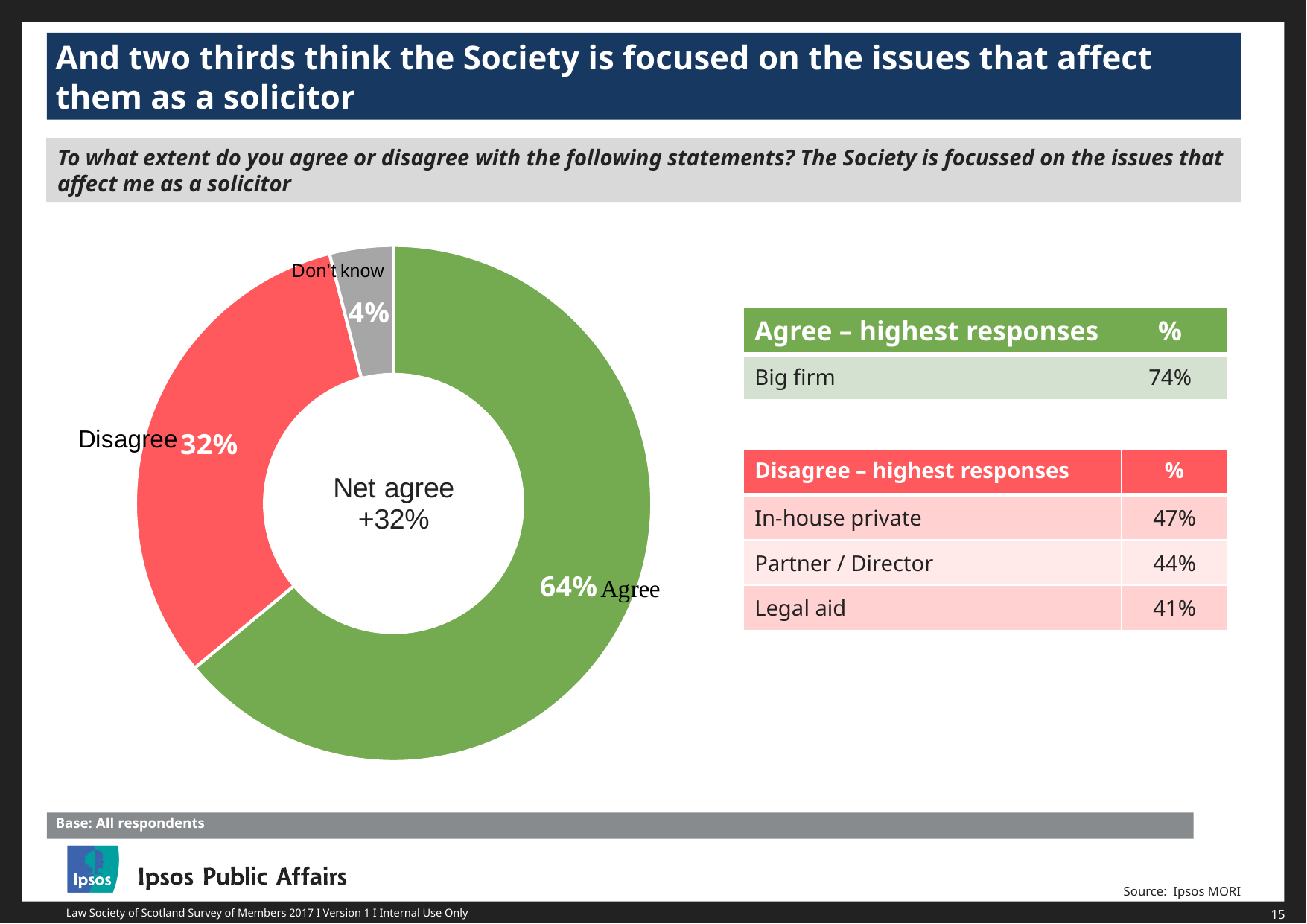
Which is larger, the Disagree share or the Don't know share? Disagree What type of chart is shown on the slide? Pie chart (doughnut) What is the combined share of Agree and Disagree? 96% What is the difference in percentage points between Agree and Disagree? 32 What colour is the Agree segment of the chart? Green Which response category has the largest share of the pie? Agree What percentage of respondents disagree? 32% How many categories are shown in the pie chart? 3 What is the net agree figure shown in the centre of the chart? +32% What percentage of respondents answered 'Don't know'? 4% What percentage of respondents agree that the Society is focused on the issues that affect them as a solicitor? 64% Which response category has the smallest share of the pie? Don't know